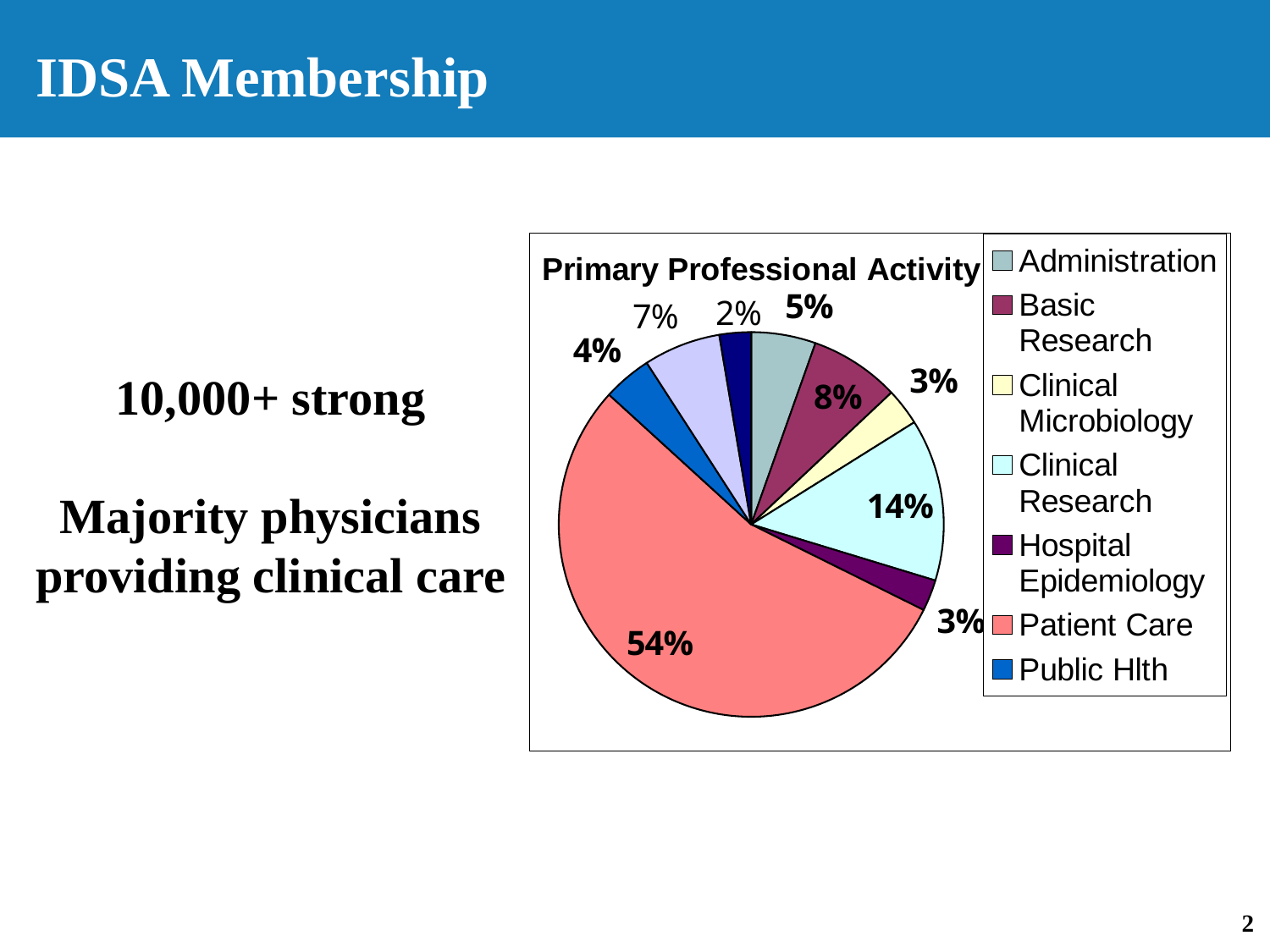
Which category has the largest slice of the pie? Patient Care What percentage is shown for Public Hlth? 4% What is the smallest percentage labelled on the pie? 2% What percentage is shown for Administration? 5% What percentage is shown for Basic Research? 8% What percentage is shown for Clinical Research? 14% How many entries does the legend list? 7 How many slices does the pie chart have? 9 What type of chart is shown on the slide? Pie chart What percentage of the pie is Patient Care? 54% Which is larger, Basic Research or Administration? Basic Research How many percentage points larger is Patient Care than Clinical Research? 40%